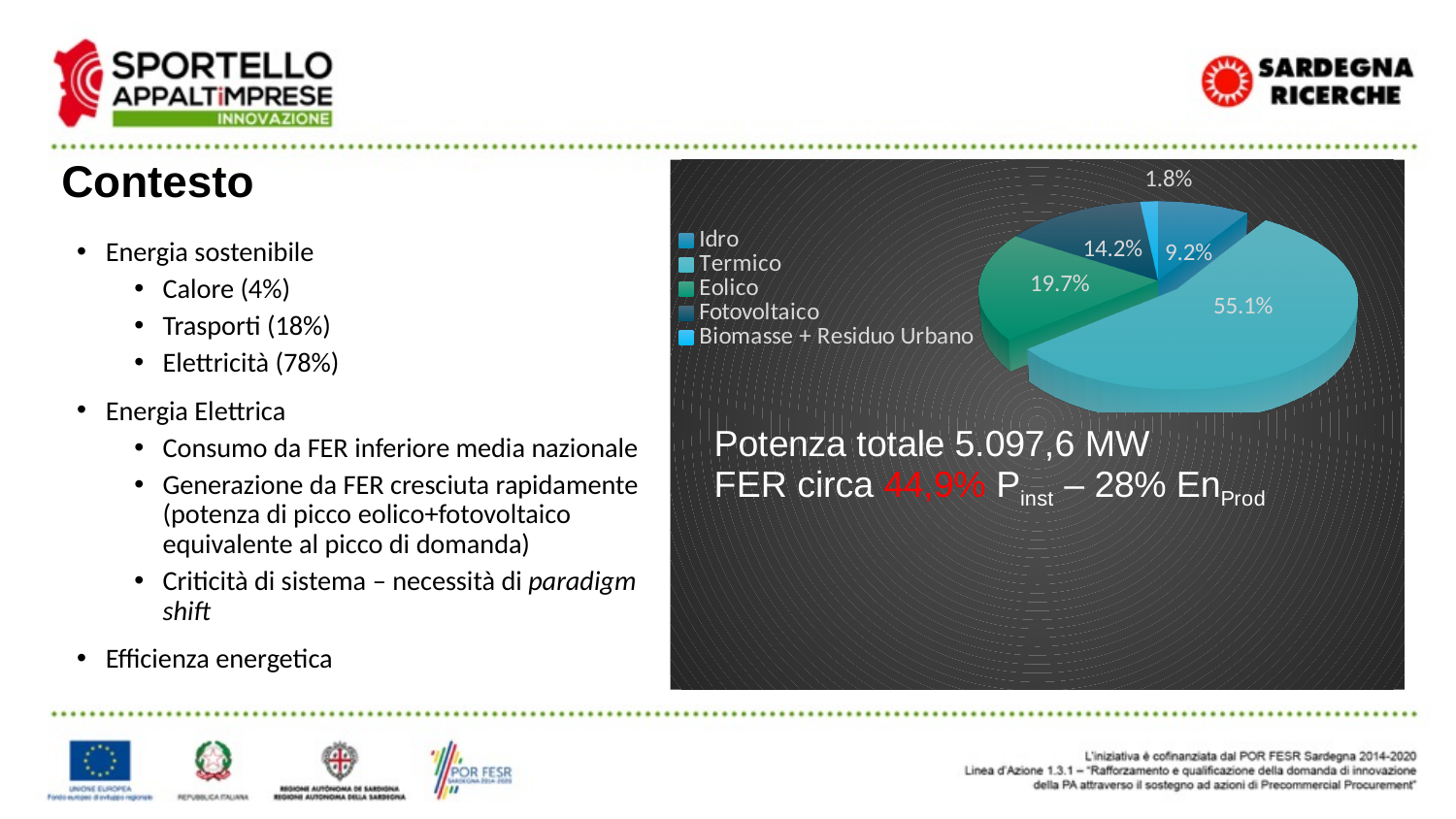
What kind of chart is shown on the slide? pie chart What is the difference in percentage points between the Termico slice (55.1%) and the Eolico slice (19.7%)? 35.4 Which category has the largest slice in the pie chart? Termico What share of the pie does Idro represent? 9.2% What share of the pie does Eolico represent? 19.7% Which category has the smallest slice in the pie chart? Biomasse + Residuo Urbano What is the largest share shown in the pie chart? 55.1% What share of the pie does Fotovoltaico represent? 14.2% What is the first entry listed in the pie chart's legend? Idro How many categories does the pie chart's legend list? 5 Which slice is larger, Eolico or Fotovoltaico? Eolico What is the smallest share shown in the pie chart? 1.8%